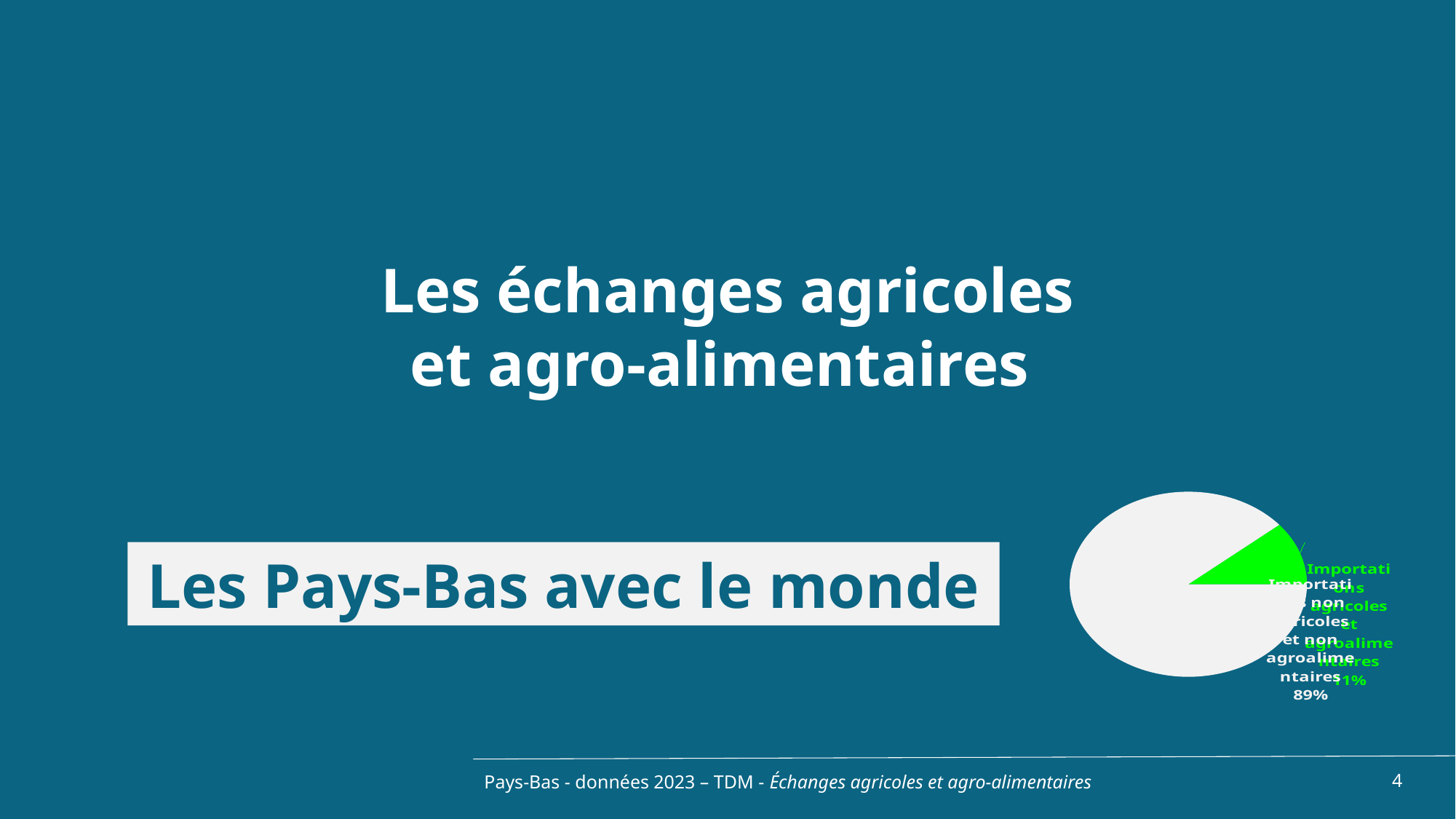
What colour is the slice representing Importations agricoles et agroalimentaires? green What colour is the slice representing Importations non agricoles et non agroalimentaires? white Which slice of the pie chart is the largest? Importations non agricoles et non agroalimentaires Which slice of the pie chart is the smallest? Importations agricoles et agroalimentaires What is the difference in percentage points between the 89% slice and the 11% slice? 78 How many slices does the pie chart have? 2 What percentage is shown for the white slice (Importations non agricoles et non agroalimentaires)? 89% Which is larger: the share of Importations agricoles et agroalimentaires or the share of Importations non agricoles et non agroalimentaires? Importations non agricoles et non agroalimentaires What percentage is shown for the green slice (Importations agricoles et agroalimentaires)? 11% What kind of chart is shown on the slide? pie chart What share of the pie is labelled 89%? Importations non agricoles et non agroalimentaires